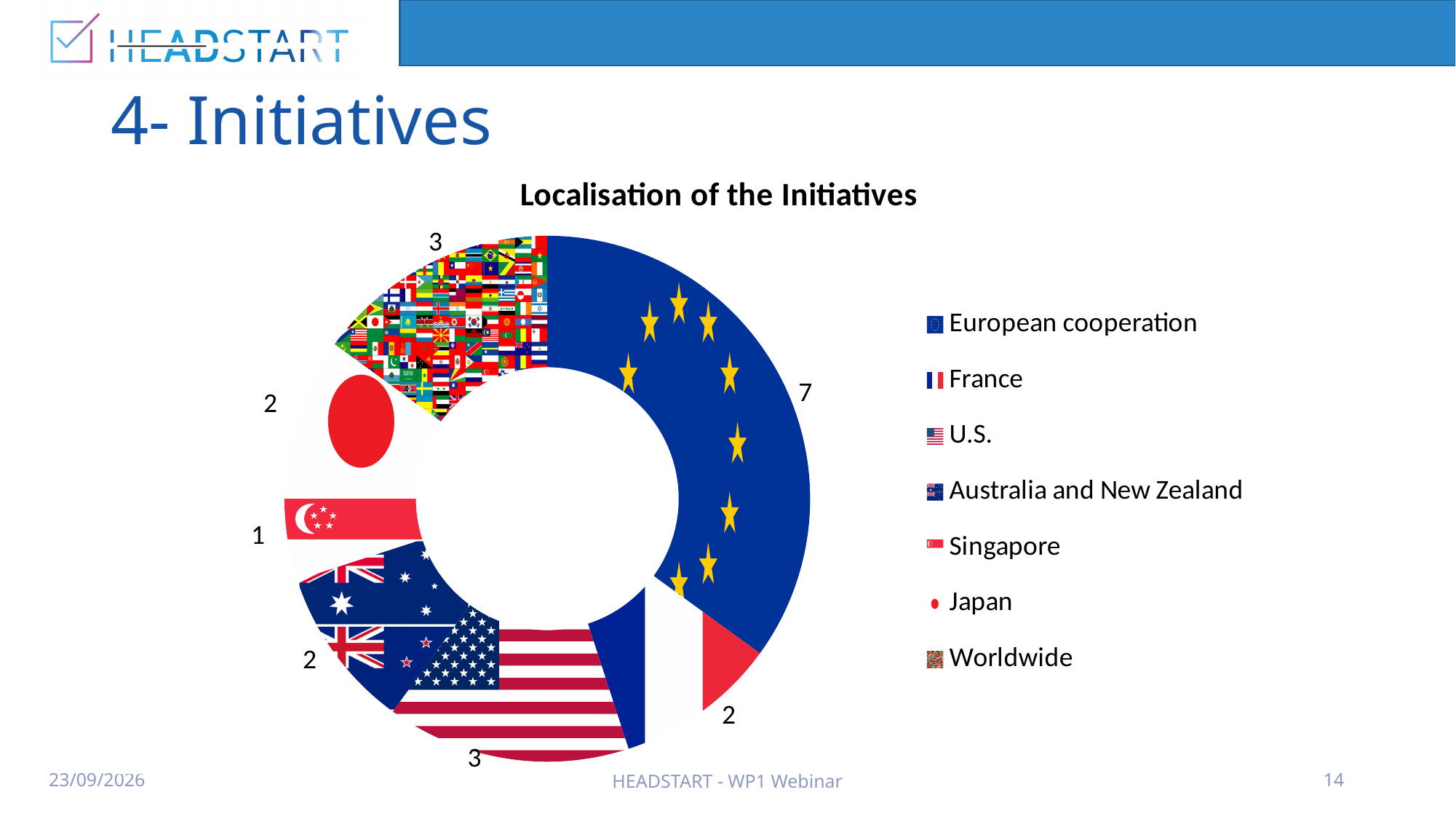
What is the title of the chart on the slide? Localisation of the Initiatives How many categories does the Localisation of the Initiatives chart show? 7 What kind of chart is the Localisation of the Initiatives chart? Doughnut chart What value is shown for Japan in the Localisation of the Initiatives chart? 2 What share of the total do the European cooperation initiatives represent in the Localisation of the Initiatives chart? 35% Which category has the largest value in the Localisation of the Initiatives chart? European cooperation Which category has the smallest value in the Localisation of the Initiatives chart? Singapore What value is shown for Singapore in the Localisation of the Initiatives chart? 1 What value is shown for the U.S. in the Localisation of the Initiatives chart? 3 Which has a larger value in the Localisation of the Initiatives chart, the U.S. or France? U.S. What value is shown for European cooperation in the Localisation of the Initiatives chart? 7 What is the difference between the values for European cooperation and Worldwide in the Localisation of the Initiatives chart? 4